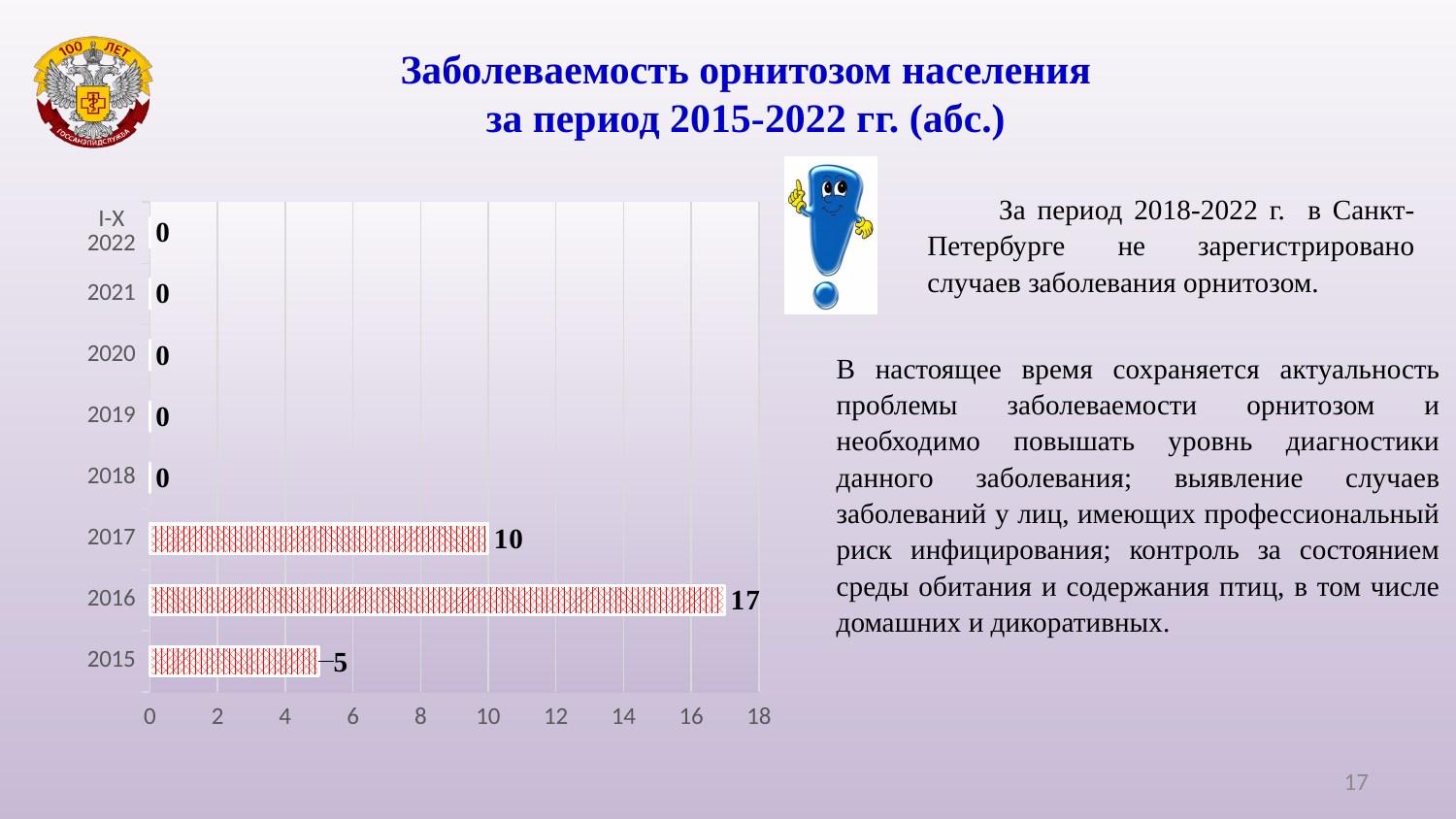
What is the value for 2015? 5 How many categories are shown on the chart? 8 What is the difference between the values for 2017 and 2015? 5 How many years have a value of 0? 5 What is the title of the chart? Заболеваемость орнитозом населения за период 2015-2022 гг. (абс.) What is the value for 2019? 0 Which year has the highest value? 2016 What is the value for 2016? 17 What is the value for 2017? 10 What kind of chart is shown on the slide? bar chart What is the difference between the values for 2016 and 2017? 7 Which is larger, the value for 2015 or the value for 2017? 2017